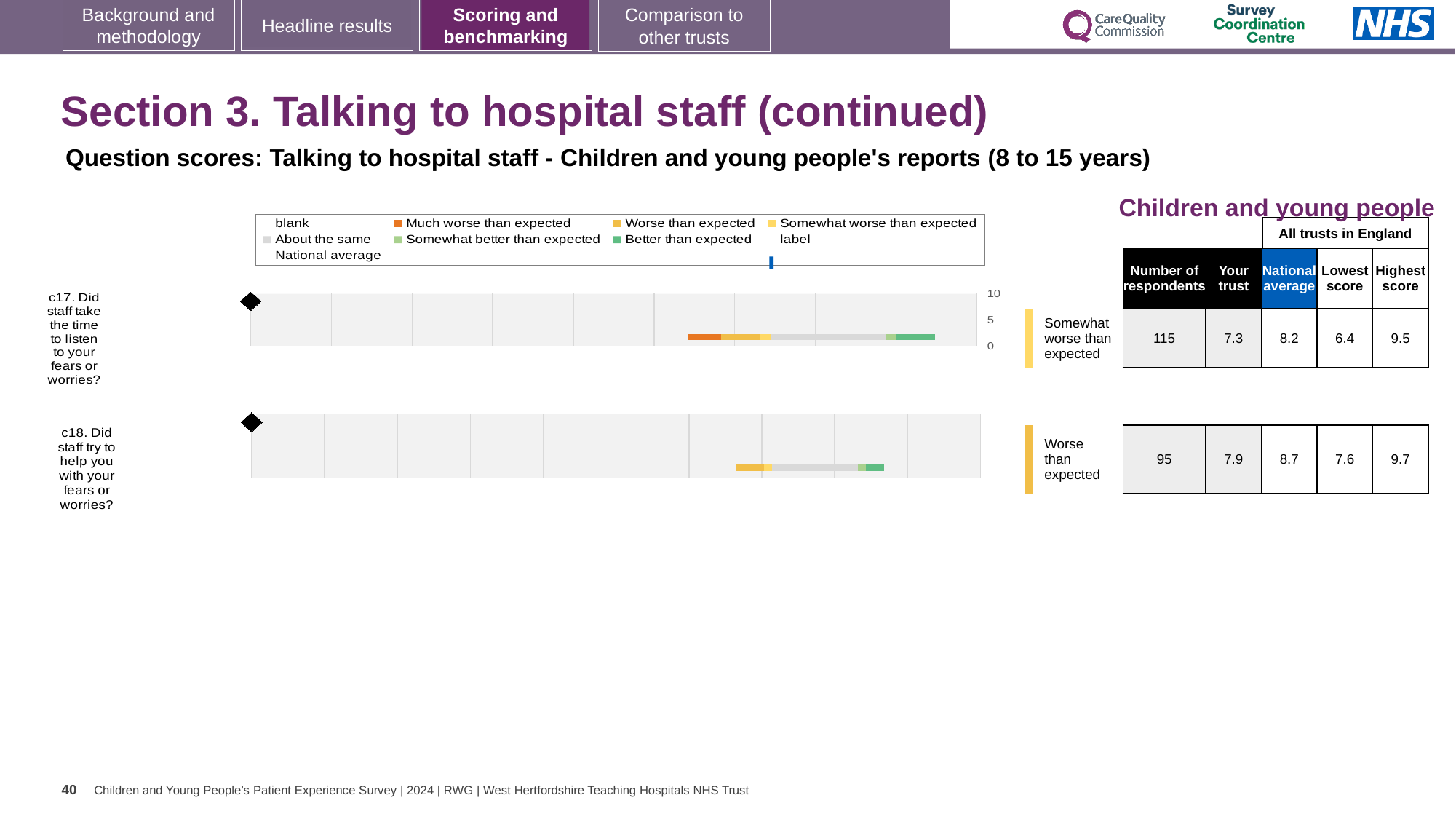
How many survey questions are plotted on the chart? 2 What benchmark category is shown for c17? Somewhat worse than expected What is the difference between the national average and the trust score for c18? 0.8 What is the national average score for c18 (Did staff try to help you with your fears or worries?)? 8.7 How many respondents answered c17? 115 What is the lowest score among all trusts in England for c18? 7.6 What is the difference between the highest and lowest scores for c17? 3.1 What benchmark category is shown for c18? Worse than expected Which question has the higher 'Highest score' across all trusts in England? c18 Which question has the higher 'Your trust' score, c17 or c18? c18 What kind of chart is used to show the question scores for c17 and c18? bar chart What is the 'Your trust' score for c17 (Did staff take the time to listen to your fears or worries?)? 7.3